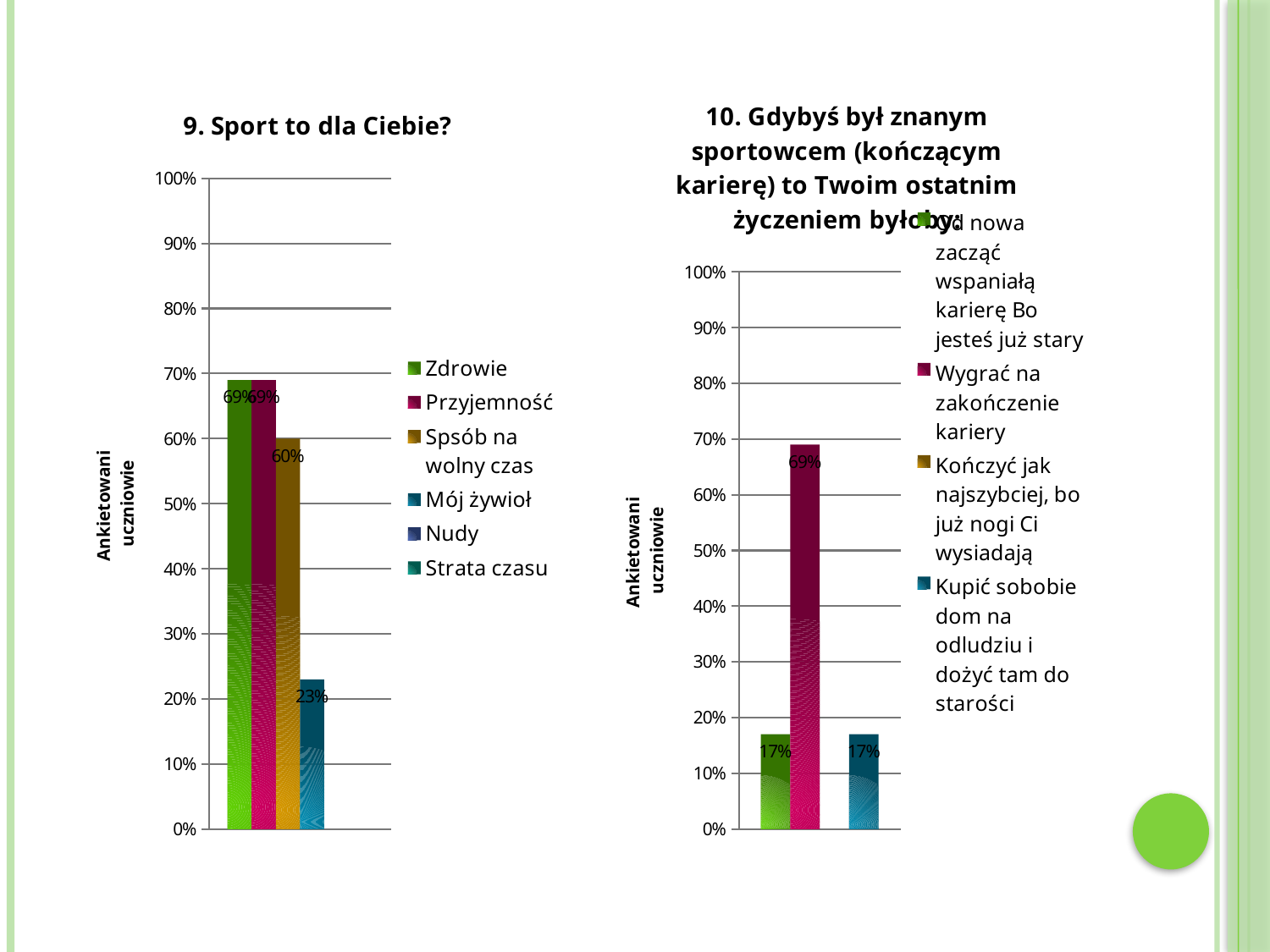
In the chart on the right ('10. Gdybyś był znanym sportowcem...'), what is the value for 'Wygrać na zakończenie kariery'? 69% In the chart on the right ('10. Gdybyś był znanym sportowcem...'), what is the value for 'Kupić sobobie dom na odludziu i dożyć tam do starości'? 17% In the chart '9. Sport to dla Ciebie?', what is the value for Spsób na wolny czas? 60% In the chart '9. Sport to dla Ciebie?', what is the value for Zdrowie? 69% In the chart '9. Sport to dla Ciebie?', what is the value for Mój żywioł? 23% What kind of chart is '9. Sport to dla Ciebie?'? Bar chart In the chart on the right ('10. Gdybyś był znanym sportowcem...'), how many series does the legend list? 4 In the chart '9. Sport to dla Ciebie?', which is larger, Przyjemność or Mój żywioł? Przyjemność In the chart '9. Sport to dla Ciebie?', what is the difference between the values for Spsób na wolny czas and Mój żywioł? 37% In the chart on the right ('10. Gdybyś był znanym sportowcem...'), which series has the highest value? Wygrać na zakończenie kariery In the chart '9. Sport to dla Ciebie?', how many series does the legend list? 6 In the chart on the right ('10. Gdybyś był znanym sportowcem...'), what is the difference between the value for 'Wygrać na zakończenie kariery' and the value for 'Kupić sobobie dom na odludziu i dożyć tam do starości'? 52%